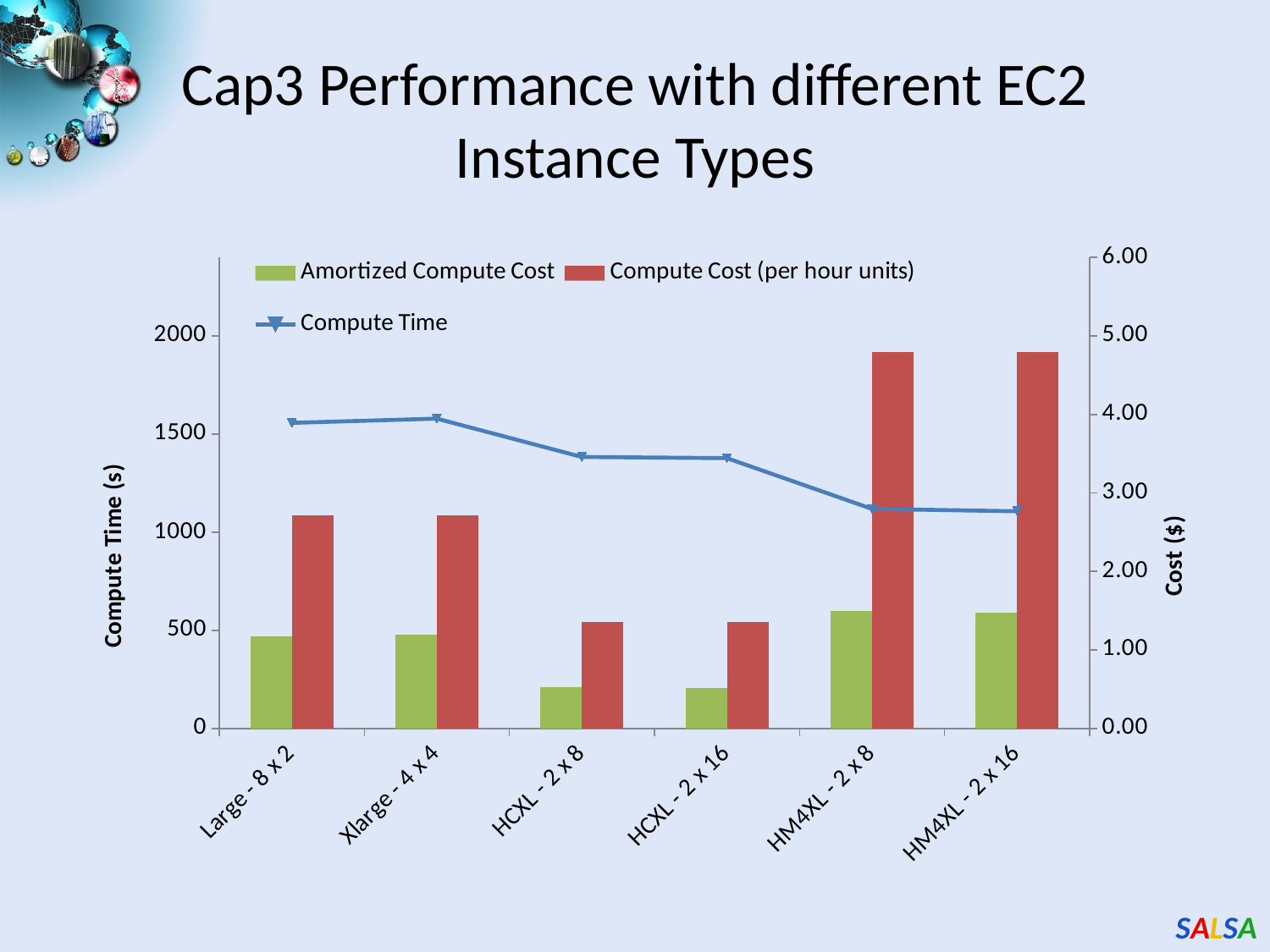
Is the Compute Time for HCXL - 2 x 8 greater or less than 1500 s? less What kind of chart is shown on the slide? A combined bar and line chart Which has the larger Compute Time: Large - 8 x 2 or HM4XL - 2 x 16? Large - 8 x 2 Is the Compute Time for HM4XL - 2 x 8 greater or less than 1000 s? greater Is the Compute Cost (per hour units) for HM4XL - 2 x 16 greater or less than 4.00? greater How many EC2 instance types are shown along the x axis? 6 How many series does the legend list? 3 Does the Compute Time line rise or fall from Large - 8 x 2 to HM4XL - 2 x 16? Falls What is the label of the right-hand vertical axis? Cost ($) Which has the larger Compute Cost (per hour units): HM4XL - 2 x 8 or Large - 8 x 2? HM4XL - 2 x 8